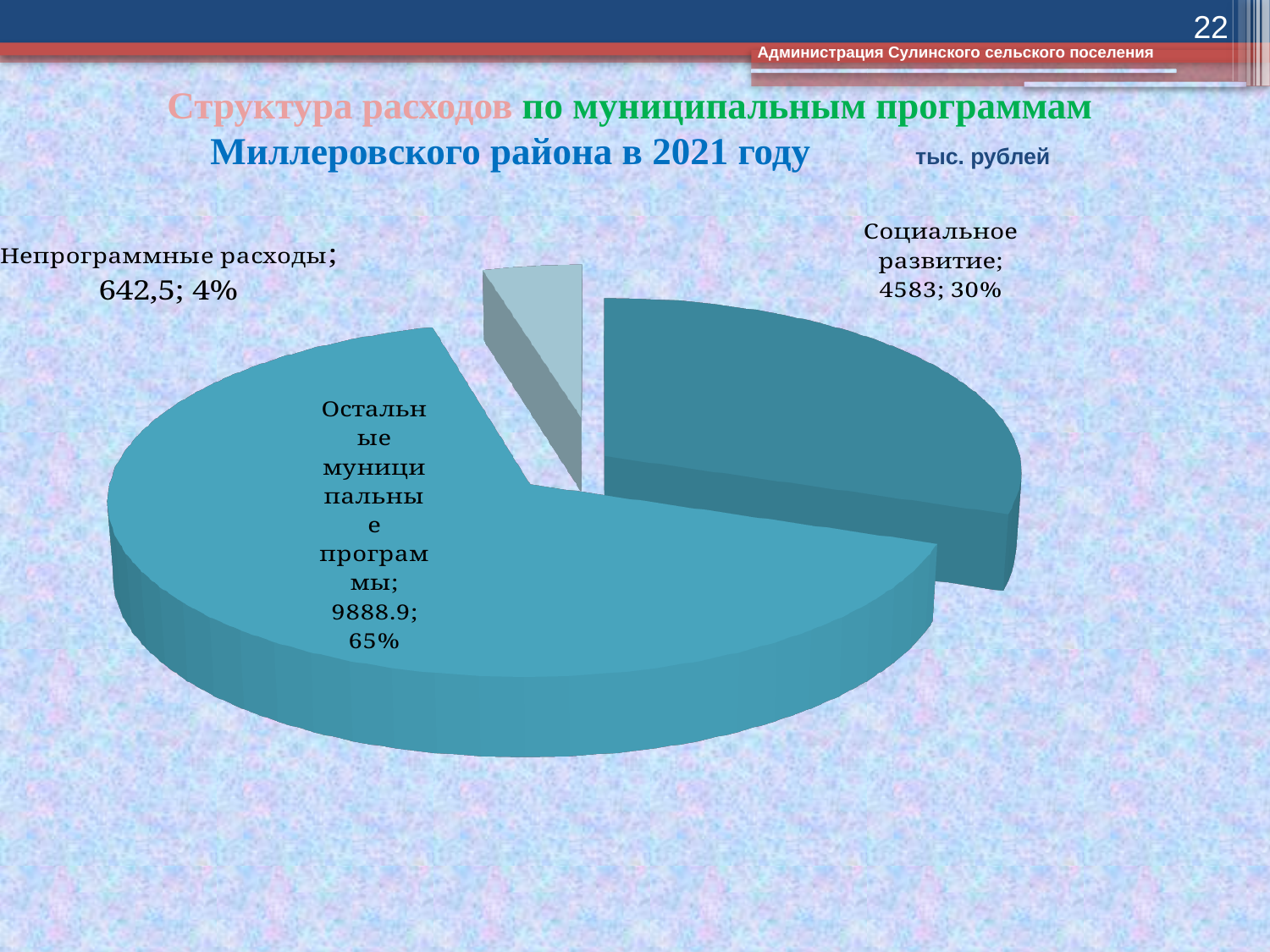
What share of the pie does Непрограммные расходы take? 4% How many slices does the pie chart have? 3 What share of the pie does Остальные муниципальные программы take? 65% Which category has the smallest slice? Непрограммные расходы What kind of chart is shown on the slide? pie chart What share of the pie does Социальное развитие take? 30% What is the difference between the values for Остальные муниципальные программы and Социальное развитие? 5305.9 Which category has the largest slice? Остальные муниципальные программы Which is larger, Социальное развитие or Непрограммные расходы? Социальное развитие What is the value for Непрограммные расходы? 642,5 What is the value for Социальное развитие? 4583 What is the value for Остальные муниципальные программы? 9888.9